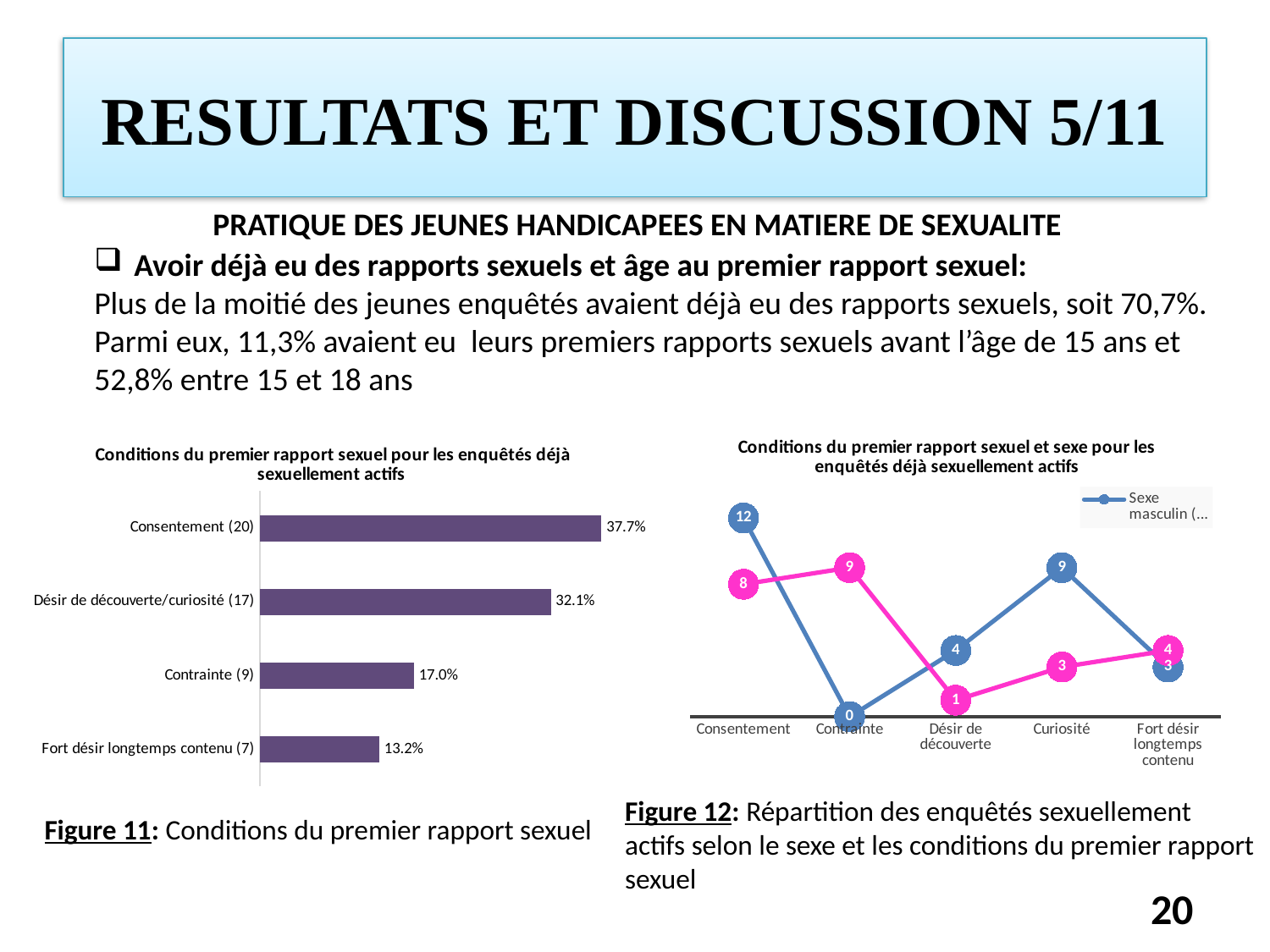
In the left chart (Figure 11), which category has the lowest value? Fort désir longtemps contenu (7) In the right chart (Figure 12), what is the value of the blue line (Sexe masculin) for Consentement? 12 What type of chart is the left chart (Figure 11)? Bar chart In the left chart (Figure 11), what is the value for Contrainte (9)? 17.0% What type of chart is the right chart (Figure 12)? Line chart In the right chart (Figure 12), what is the value of the pink line for Contrainte? 9 In the left chart (Figure 11), what is the value for Consentement (20)? 37.7% In the right chart (Figure 12), what is the difference between the blue and pink lines at Consentement? 4 In the left chart (Figure 11), what is the difference between Consentement (20) and Désir de découverte/curiosité (17)? 5.6% In the right chart (Figure 12), which is larger for Curiosité: the blue line or the pink line? Blue line In the left chart (Figure 11), which category has the highest value? Consentement (20) In the left chart (Figure 11), how many categories are shown? 4